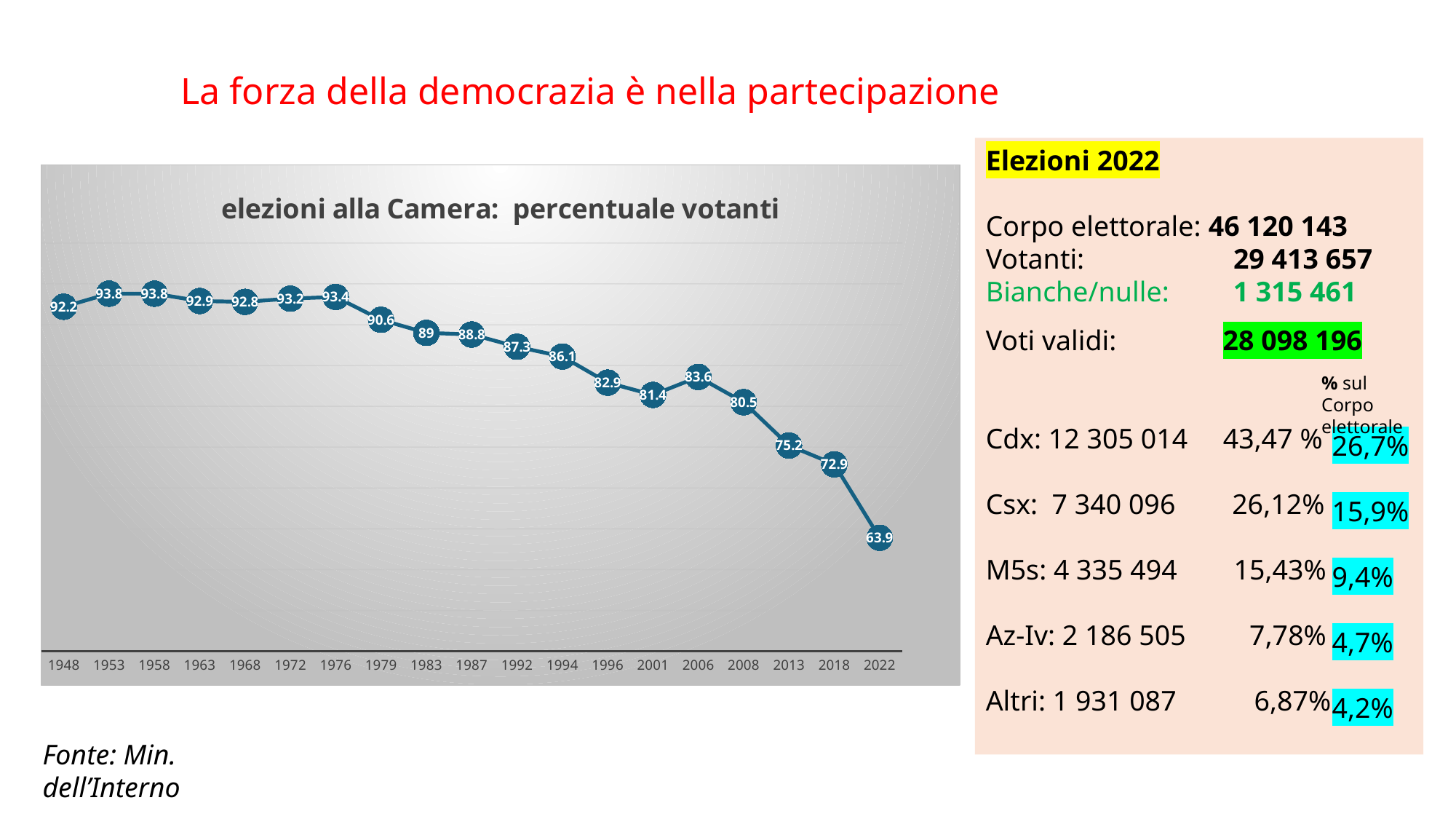
What type of chart is shown on the slide? line chart How many years (data points) are plotted in the chart? 19 Do the values generally rise or fall from 1976 to 2022? fall What is the difference between the values for 1948 and 2022? 28.3 What is the difference between the values for 2018 and 2022? 9 What is the value for 2006 in the chart? 83.6 Which year has the lowest value in the chart? 2022 Which year has the larger value, 2001 or 2006? 2006 What is the value for 2022 in the chart? 63.9 What is the value for 1976 in the chart? 93.4 What is the title of the chart? elezioni alla Camera: percentuale votanti What is the value for 1948 in the chart? 92.2